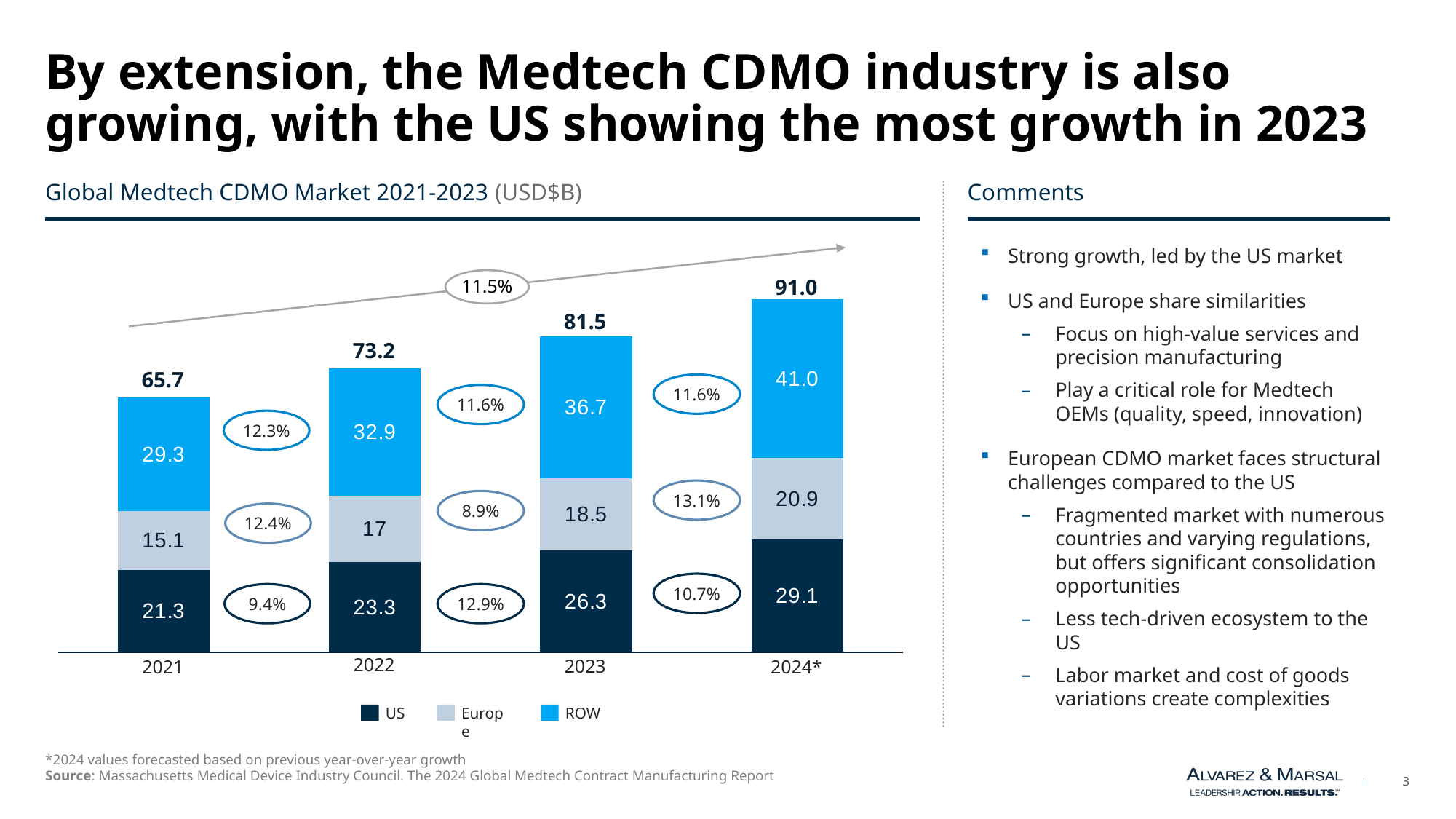
How many series does the legend list? 3 Do the total market values rise or fall from 2021 to 2024*? Rise Which year has the highest total market value? 2024* What is the difference between the ROW value in 2024* and the ROW value in 2023? 4.3 Which year has the lowest US value? 2021 Which is larger in 2022, the Europe value or the US value? US What is the Europe value for 2024*? 20.9 What is the ROW value for 2022? 32.9 What is the US value for 2023? 26.3 What kind of chart is shown? Stacked bar chart What is the total of the stacked bar for 2021? 65.7 How many years are shown on the x axis? 4